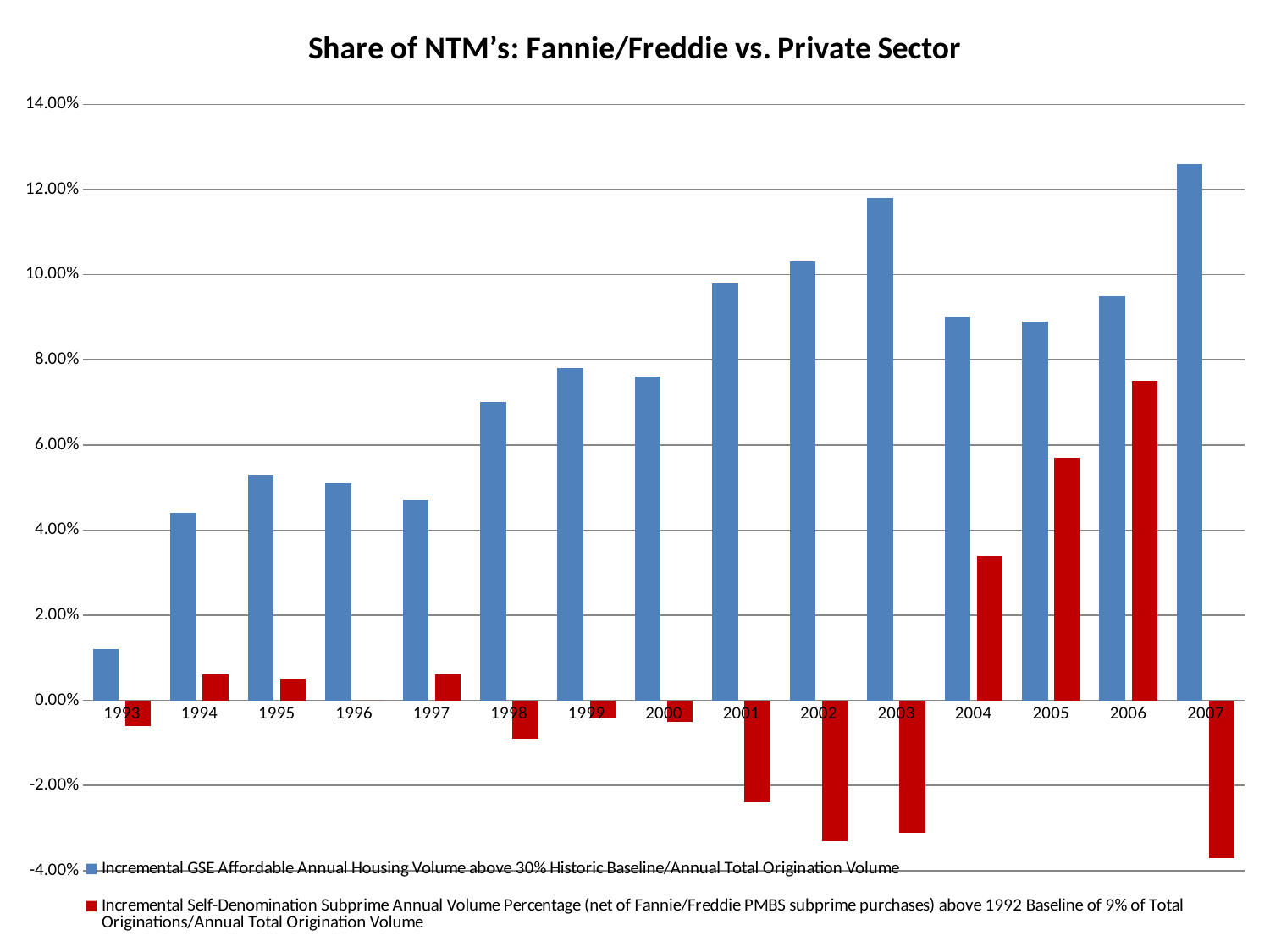
In which year is the red (Self-Denomination Subprime) series lowest? 2007 Is the blue bar for 2003 greater or less than 10.00%? greater What is the title of the chart? Share of NTM's: Fannie/Freddie vs. Private Sector Which is larger, the blue bar for 2002 or the blue bar for 2004? 2002 How many years are shown on the x axis? 15 In which year is the blue (GSE Affordable Housing) series lowest? 1993 What kind of chart is shown on the slide? bar chart How many series does the legend list? 2 Is the blue bar for 1993 greater or less than 2.00%? less In which year is the red (Self-Denomination Subprime) series highest? 2006 Is the red bar for 2002 greater or less than -2.00%? less In which year is the blue (GSE Affordable Housing) series highest? 2007